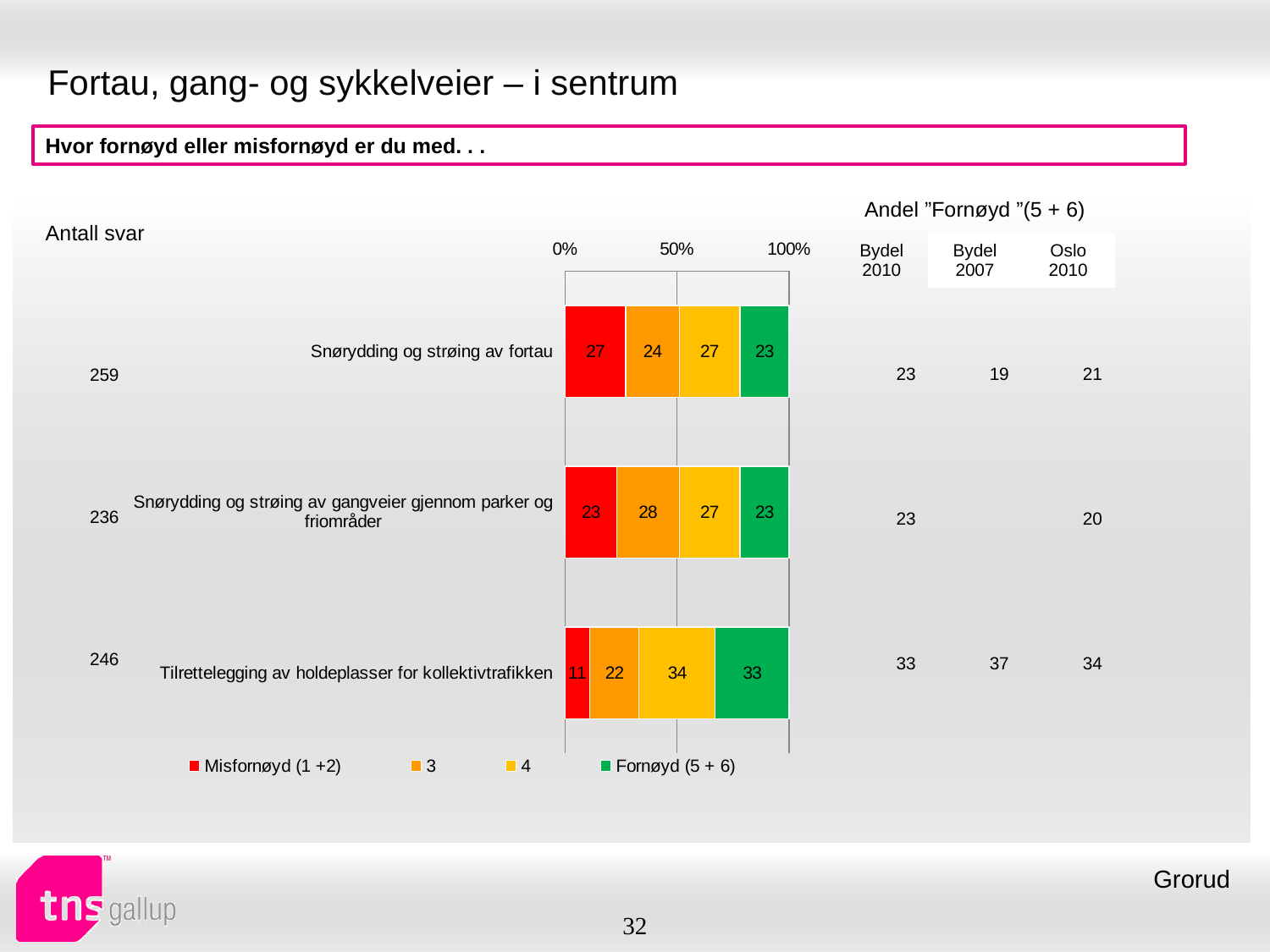
What kind of chart is shown on the slide? Stacked bar chart How many categories are shown in the chart? 3 What is the value of the Fornøyd (5 + 6) segment for "Tilrettelegging av holdeplasser for kollektivtrafikken"? 33 What is the total of the stacked bar for "Tilrettelegging av holdeplasser for kollektivtrafikken"? 100 What is the difference between the Misfornøyd (1 +2) values for "Snørydding og strøing av fortau" and "Tilrettelegging av holdeplasser for kollektivtrafikken"? 16 Which category has the larger "3" segment: "Snørydding og strøing av fortau" or "Snørydding og strøing av gangveier gjennom parker og friområder"? Snørydding og strøing av gangveier gjennom parker og friområder What is the value of the "4" segment for "Tilrettelegging av holdeplasser for kollektivtrafikken"? 34 What is the first entry in the chart legend? Misfornøyd (1 +2) How many series does the legend list? 4 What is the value of the Misfornøyd (1 +2) segment for "Snørydding og strøing av fortau"? 27 Which category has the lowest Misfornøyd (1 +2) value? Tilrettelegging av holdeplasser for kollektivtrafikken Which category has the highest Fornøyd (5 + 6) value? Tilrettelegging av holdeplasser for kollektivtrafikken